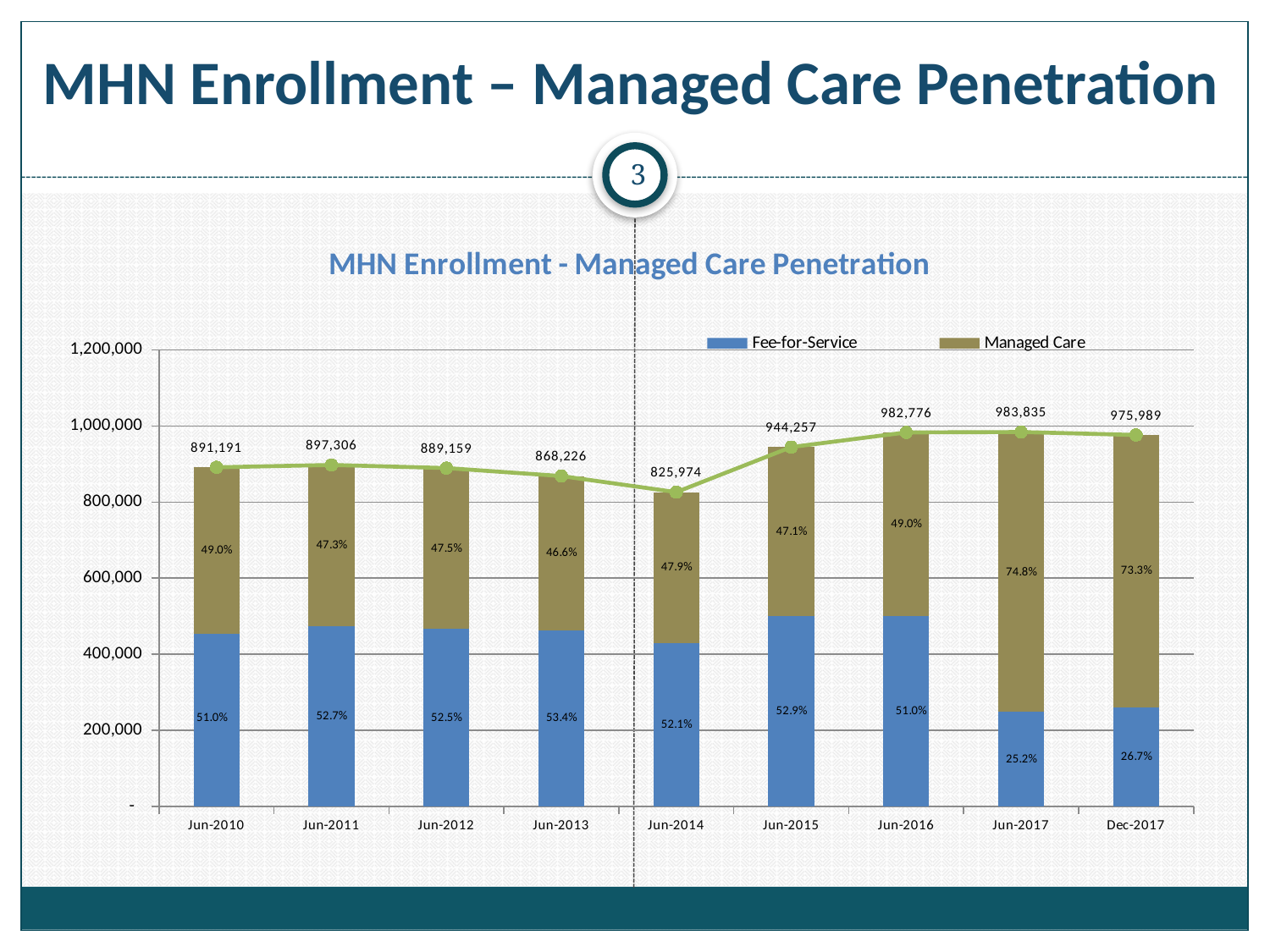
What is the difference between the total enrollment in Jun-2016 and Jun-2015? 38,519 What kind of chart is shown on the slide? Stacked bar chart with a line Does total enrollment rise or fall from Jun-2014 to Jun-2016? rise Which period has the larger total enrollment, Jun-2010 or Jun-2011? Jun-2011 Is the Fee-for-Service value for Jun-2017 greater or less than 400,000? less What percentage of enrollment was Managed Care in Jun-2017? 74.8% Which period has the highest total enrollment? Jun-2017 How many series does the legend list? 2 How many time periods are shown on the x axis? 9 What percentage of enrollment was Fee-for-Service in Dec-2017? 26.7% What is the total enrollment shown for Jun-2014? 825,974 Which period has the lowest total enrollment? Jun-2014